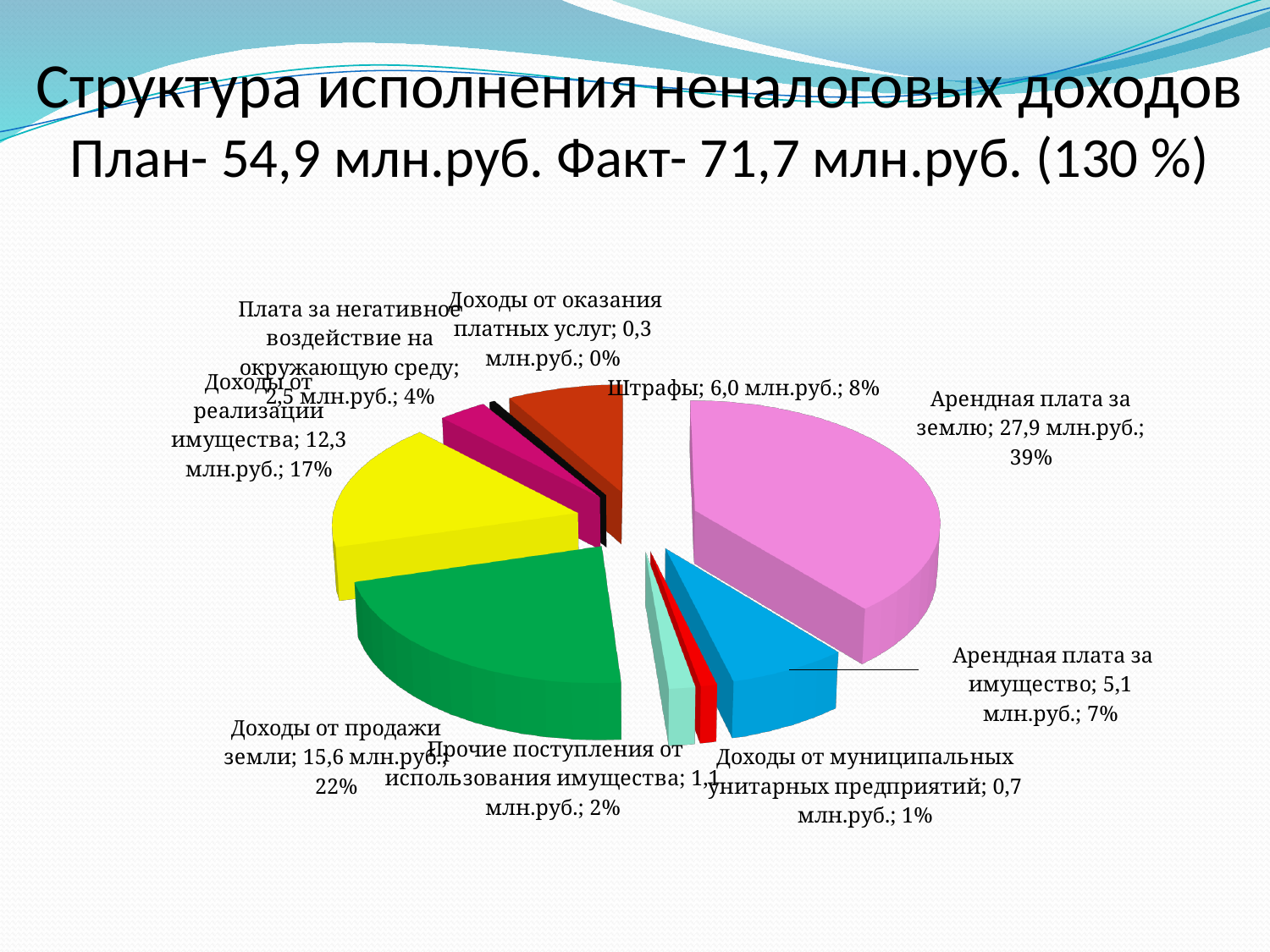
Which category has the smallest slice of the pie? Доходы от оказания платных услуг What share of the pie does Арендная плата за имущество represent? 7% How many categories are shown in the pie chart? 9 Which is larger: Штрафы or Арендная плата за имущество? Штрафы What is the value for Арендная плата за землю? 27,9 млн.руб. What is the value for Доходы от продажи земли? 15,6 млн.руб. What is the value for Штрафы? 6,0 млн.руб. What is the title of the chart on the slide? Структура исполнения неналоговых доходов What kind of chart is shown on the slide? Pie chart Which category has the largest slice of the pie? Арендная плата за землю What is the difference between the values for Арендная плата за землю and Доходы от продажи земли? 12,3 млн.руб. What share of the pie does Доходы от реализации имущества represent? 17%